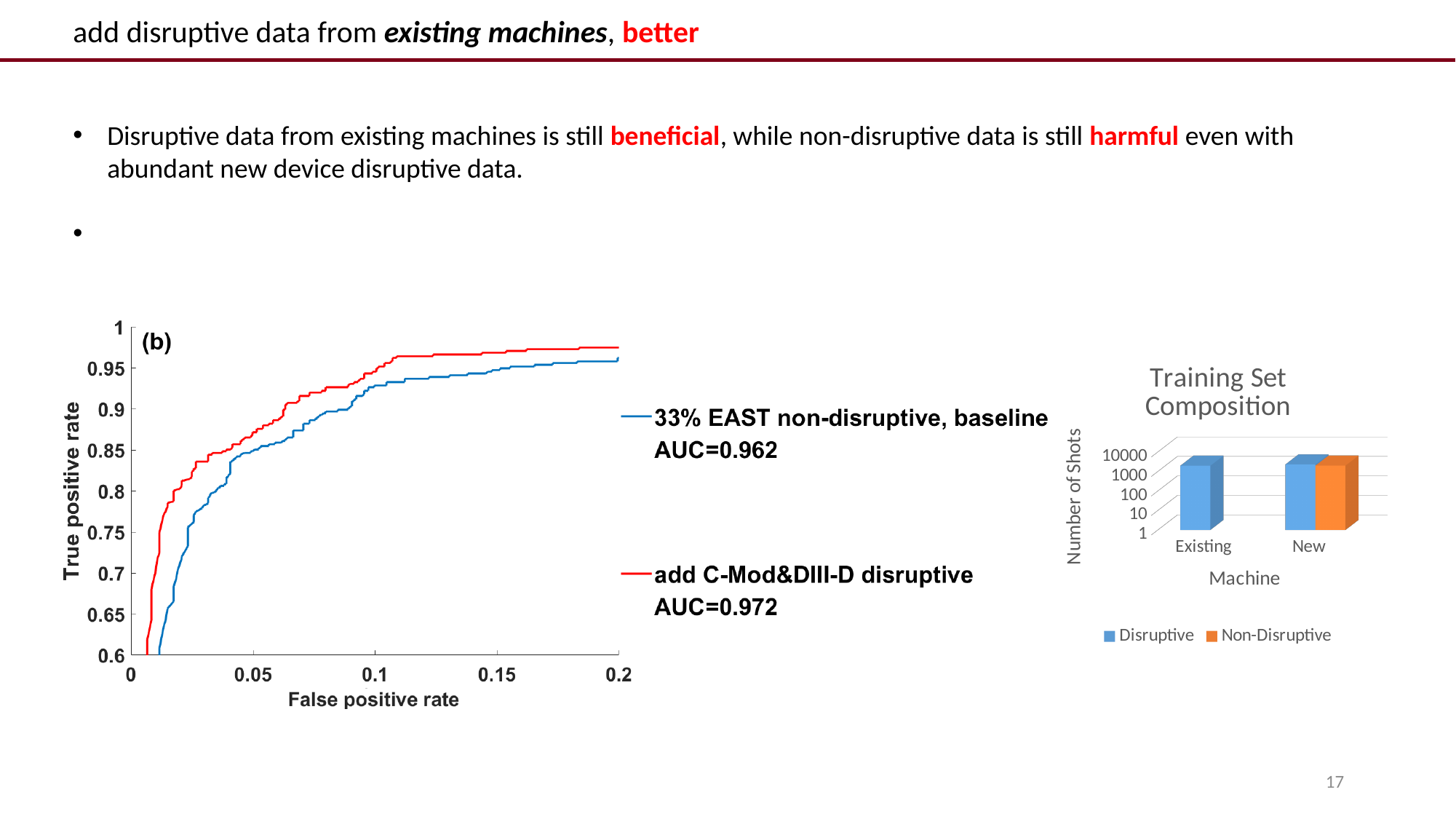
In the ROC chart on the left, what is the difference between the two AUC values? 0.010 In the Training Set Composition chart, how many series does the legend list? 2 In the ROC chart on the left, what is the AUC of the curve with added C-Mod&DIII-D disruptive data? 0.972 In the Training Set Composition chart, is the Non-Disruptive value for New greater or less than 10000? less In the Training Set Composition chart, is the Disruptive value for Existing greater or less than 1000? greater In the Training Set Composition chart, which machine category has a Non-Disruptive bar? New What kind of chart is the Training Set Composition chart? Bar chart In the ROC chart on the left, which curve has the higher AUC? add C-Mod&DIII-D disruptive In the Training Set Composition chart, how many machine categories are shown on the x axis? 2 In the Training Set Composition chart, what is the label of the vertical axis? Number of Shots In the Training Set Composition chart, what are the two series named in the legend? Disruptive and Non-Disruptive In the ROC chart on the left, what is the AUC of the 33% EAST non-disruptive baseline curve? 0.962